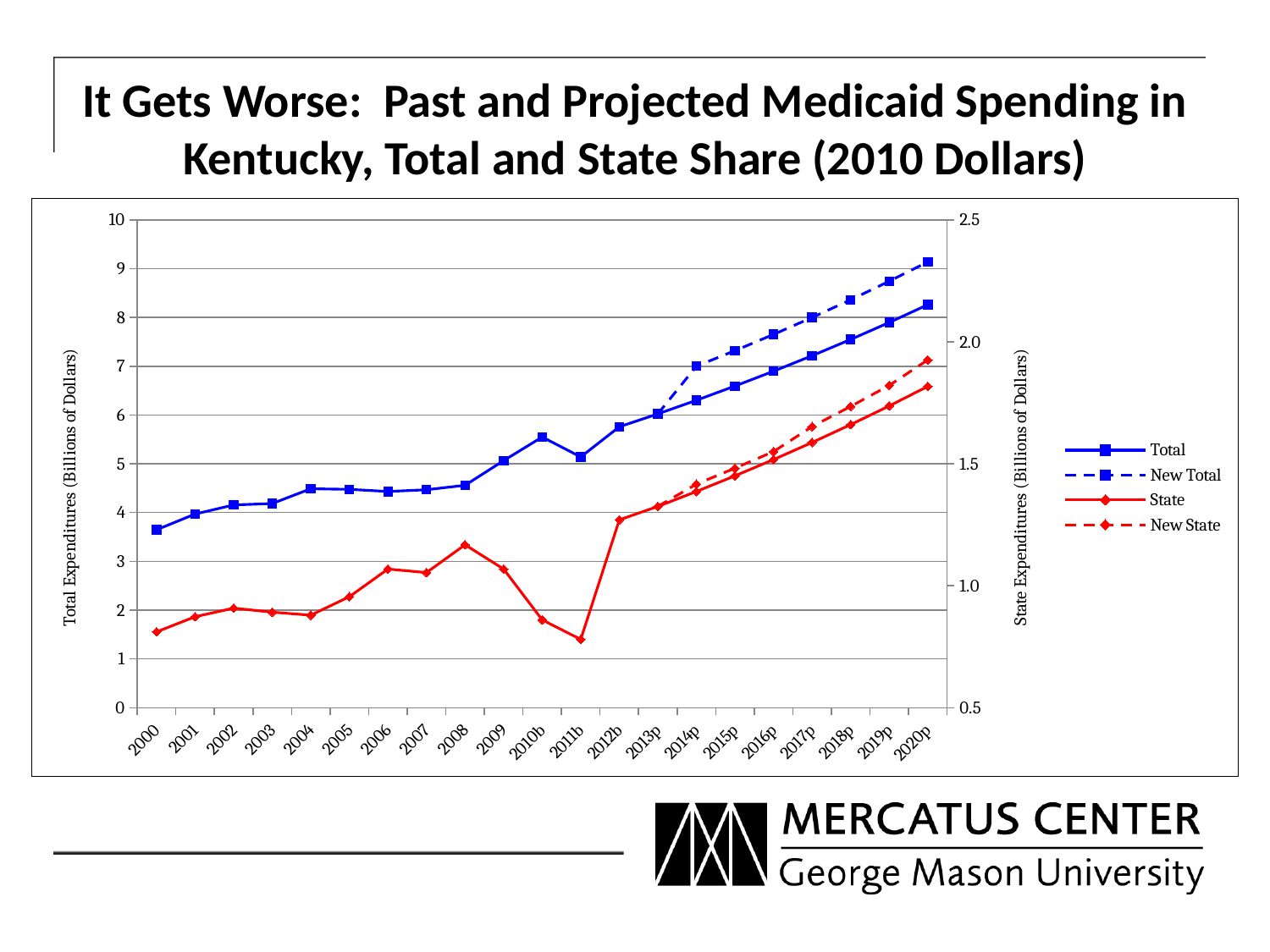
Is the Total value for 2000 greater or less than 4 billion dollars? less How many series does the legend list? 4 Which year has the lowest value for the State series? 2011b What kind of chart is shown on the slide? line chart Is the New Total value for 2020p greater or less than 9 billion dollars? greater How many years (categories) are shown along the x axis? 21 What is the label of the left vertical axis? Total Expenditures (Billions of Dollars) Does the Total series rise or fall from 2013p to 2020p? rise Is the Total value for 2020p greater or less than 8 billion dollars? greater Which year has the lowest value for the Total series? 2000 Which is larger, the Total value for 2010b or the Total value for 2011b? 2010b Which year has the highest value for the Total series? 2020p